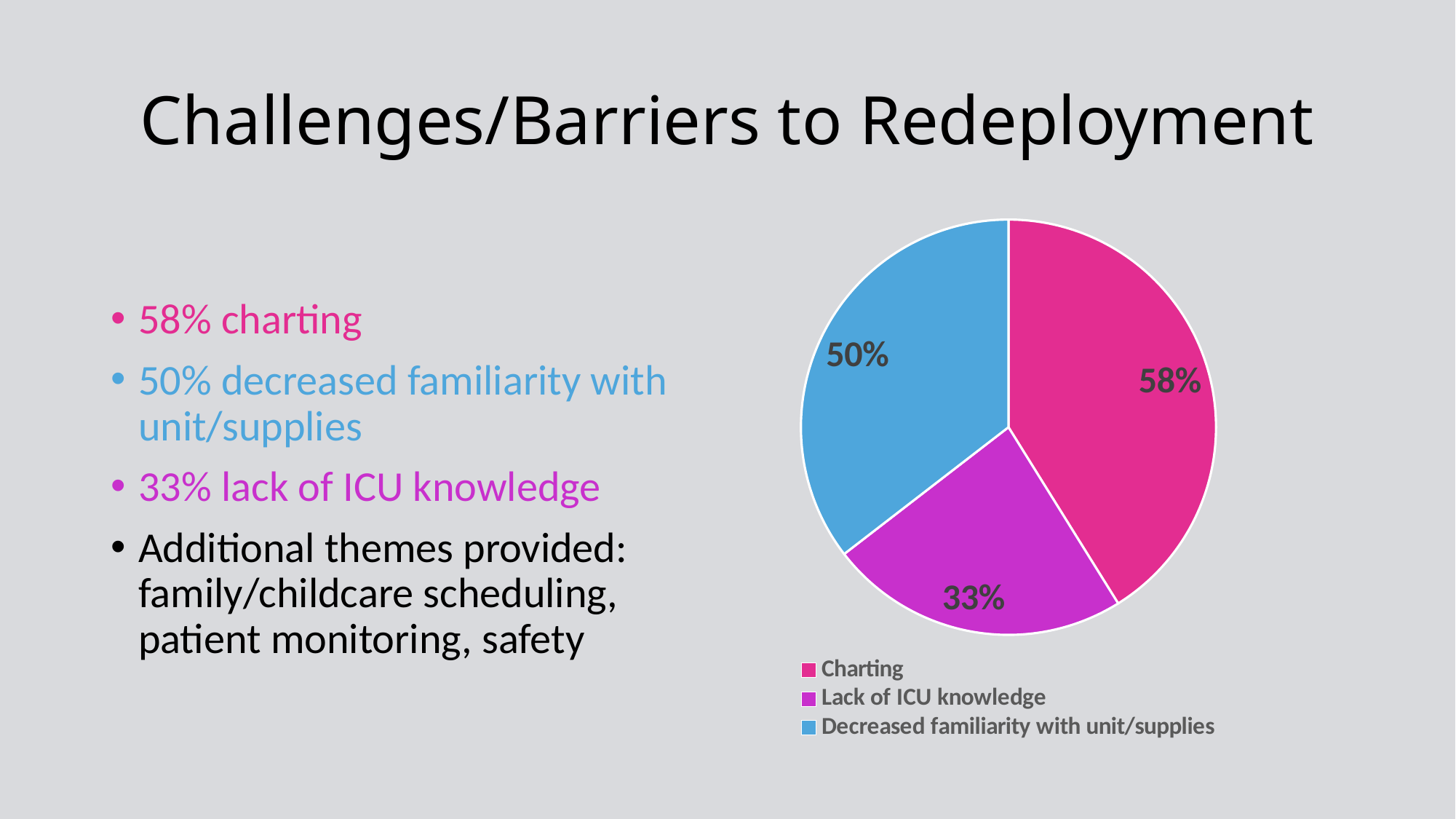
What is the difference between the values for Charting and Decreased familiarity with unit/supplies? 8% How many slices does the pie chart have? 3 Which category has the smallest slice in the pie chart? Lack of ICU knowledge What value is shown for the Lack of ICU knowledge slice? 33% Which category has the largest slice in the pie chart? Charting What type of chart is shown on the slide? Pie chart What is the difference between the values for Charting and Lack of ICU knowledge? 25% Which legend entry is shown in blue? Decreased familiarity with unit/supplies Which is larger, the value for Decreased familiarity with unit/supplies or the value for Lack of ICU knowledge? Decreased familiarity with unit/supplies What value is shown for the Charting slice of the pie chart? 58% What colour is the Charting slice in the pie chart? Pink What value is shown for the Decreased familiarity with unit/supplies slice? 50%